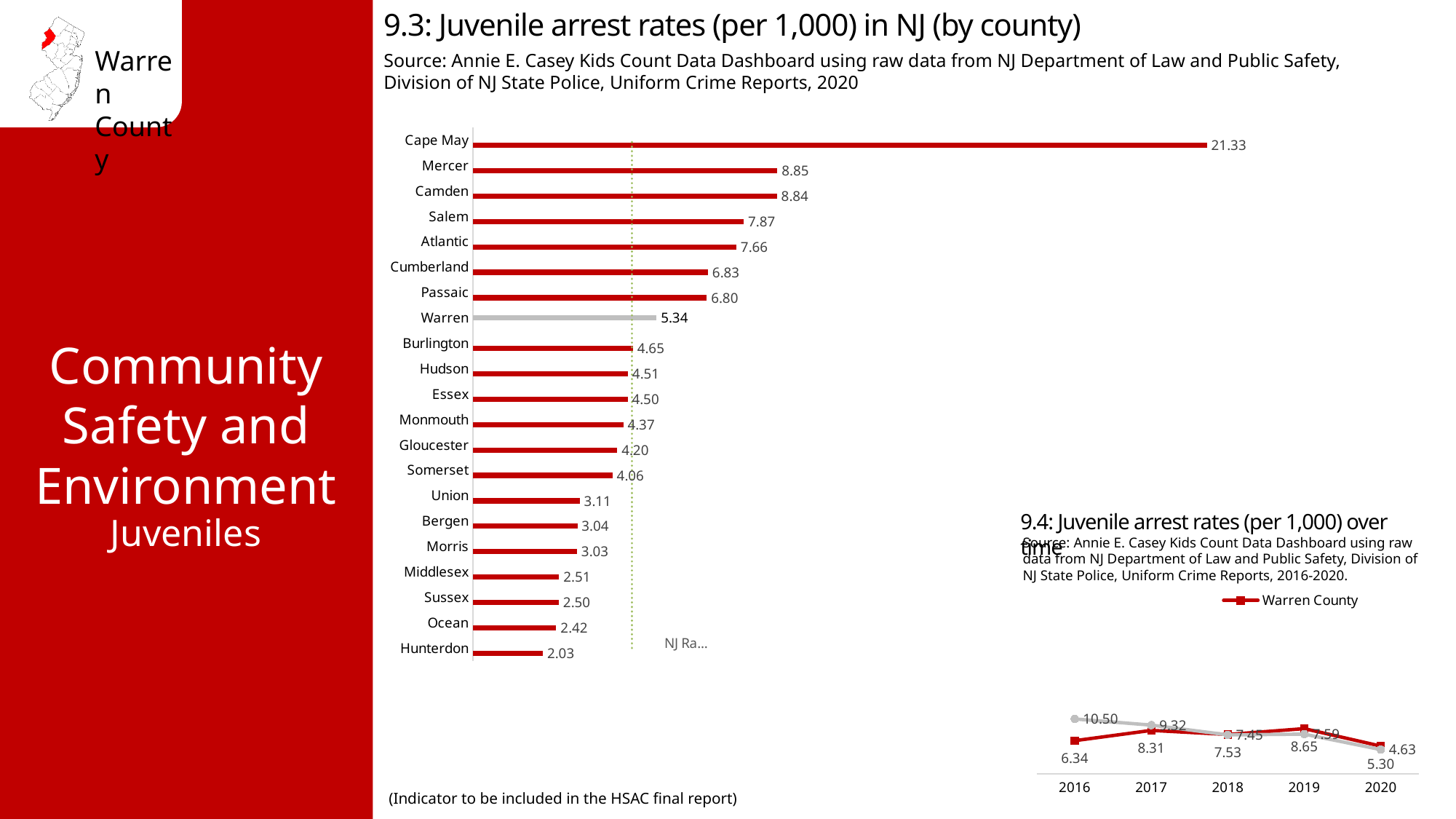
In the chart '9.3: Juvenile arrest rates (per 1,000) in NJ (by county)', what is the value for Cape May? 21.33 In the chart '9.4: Juvenile arrest rates (per 1,000) over time', what is the Warren County value for 2016? 6.34 In the chart '9.3: Juvenile arrest rates (per 1,000) in NJ (by county)', which has a higher value, Salem or Passaic? Salem In the chart '9.3: Juvenile arrest rates (per 1,000) in NJ (by county)', how many counties are shown? 21 What kind of chart is '9.4: Juvenile arrest rates (per 1,000) over time'? Line chart In the chart '9.3: Juvenile arrest rates (per 1,000) in NJ (by county)', what is the difference between the values for Cape May and Mercer? 12.48 In the chart '9.3: Juvenile arrest rates (per 1,000) in NJ (by county)', which county has the highest juvenile arrest rate? Cape May In the chart '9.4: Juvenile arrest rates (per 1,000) over time', what is the difference between the Warren County values for 2019 and 2020? 3.35 What kind of chart is '9.3: Juvenile arrest rates (per 1,000) in NJ (by county)'? Bar chart In the chart '9.3: Juvenile arrest rates (per 1,000) in NJ (by county)', which county has the lowest juvenile arrest rate? Hunterdon In the chart '9.3: Juvenile arrest rates (per 1,000) in NJ (by county)', what is the value for Warren? 5.34 In the chart '9.4: Juvenile arrest rates (per 1,000) over time', what is the Warren County value for 2019? 8.65